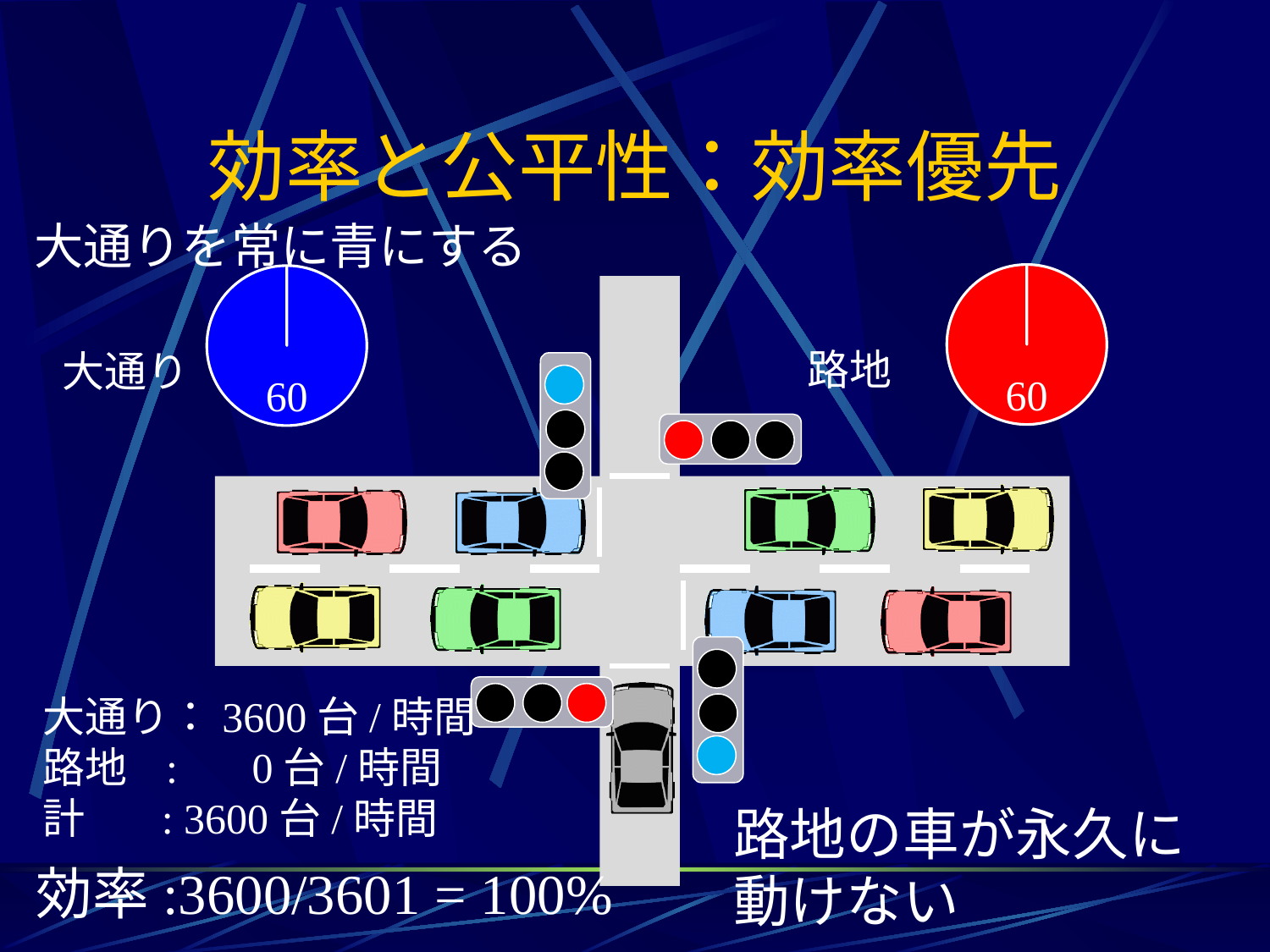
What share of the 大通り pie chart does its single slice occupy? 100% What colour is the 大通り pie chart? blue What kind of chart is the chart labelled 大通り on the left of the slide? pie chart What value is printed on the 路地 pie chart? 60 How many slices does the 路地 pie chart contain? 1 What kind of chart is the chart labelled 路地 on the right of the slide? pie chart What colour is the 路地 pie chart? red Is the value printed on the 大通り pie chart the same as the value printed on the 路地 pie chart? yes What value is printed on the 大通り pie chart? 60 How many pie charts are shown on the slide? 2 How many slices does the 大通り pie chart contain? 1